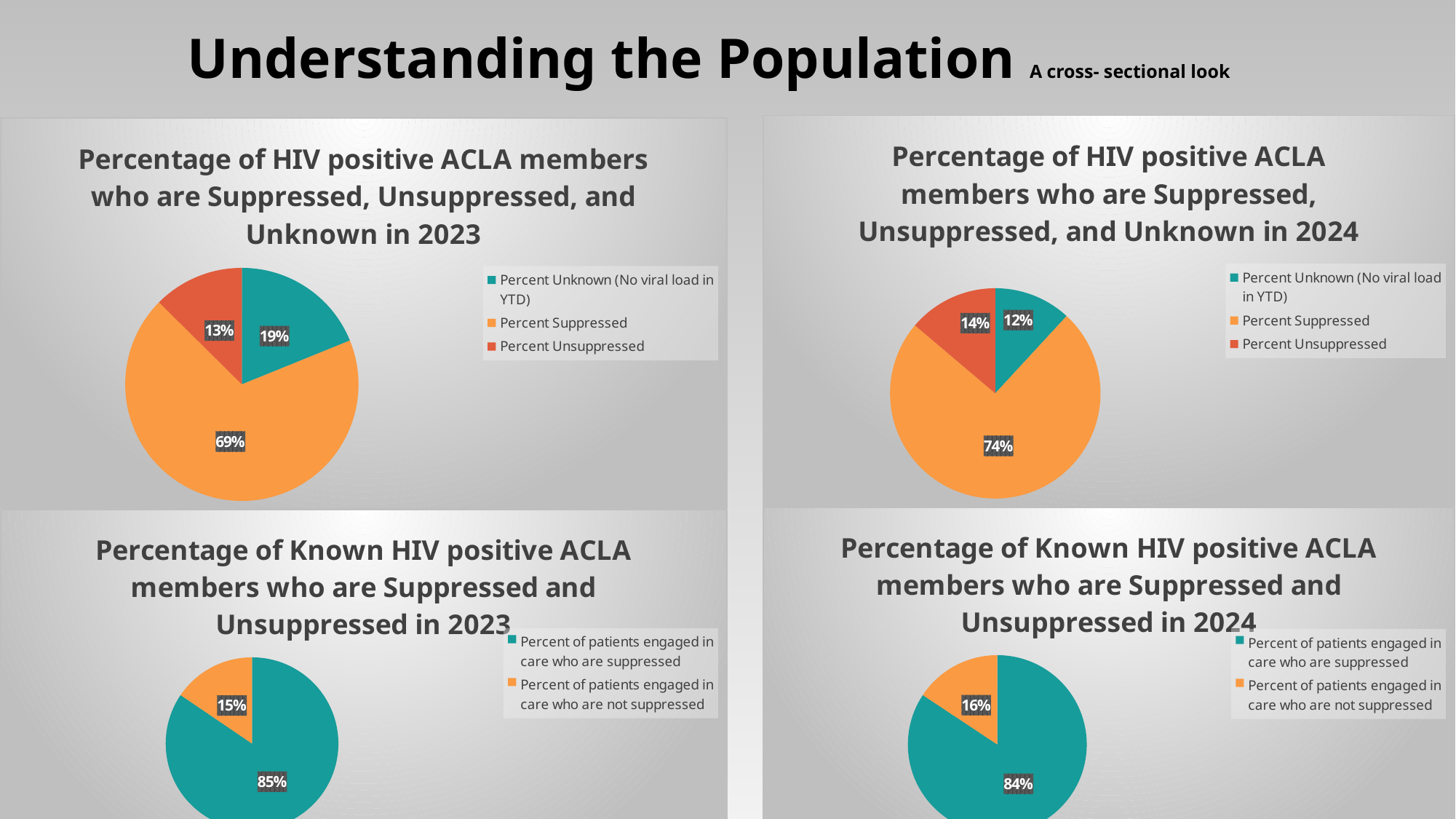
In the top-left chart (Suppressed, Unsuppressed, and Unknown in 2023), what percentage is Percent Unknown (No viral load in YTD)? 19% In the top-left chart (2023), which is larger: Percent Unknown (No viral load in YTD) or Percent Unsuppressed? Percent Unknown (No viral load in YTD) What type of chart is the bottom-right chart (Known HIV positive members in 2024)? Pie chart In the bottom-left chart (Known HIV positive members in 2023), what percentage of patients engaged in care are suppressed? 85% In the top-right chart (Suppressed, Unsuppressed, and Unknown in 2024), which category has the smallest share? Percent Unknown (No viral load in YTD) What is the difference between Percent Suppressed in the top-right chart (2024) and Percent Suppressed in the top-left chart (2023)? 5% How many categories does the legend of the top-left chart (Suppressed, Unsuppressed, and Unknown in 2023) list? 3 In the top-right chart (Suppressed, Unsuppressed, and Unknown in 2024), what percentage is Percent Unsuppressed? 14% In the top-left chart (Suppressed, Unsuppressed, and Unknown in 2023), what percentage is Percent Suppressed? 69% In the bottom-right chart (Known HIV positive members in 2024), what percentage of patients engaged in care are not suppressed? 16% In the bottom-left chart (Known HIV positive members in 2023), what colour is the slice for patients engaged in care who are suppressed? Teal In the top-right chart (Suppressed, Unsuppressed, and Unknown in 2024), which category has the largest share? Percent Suppressed